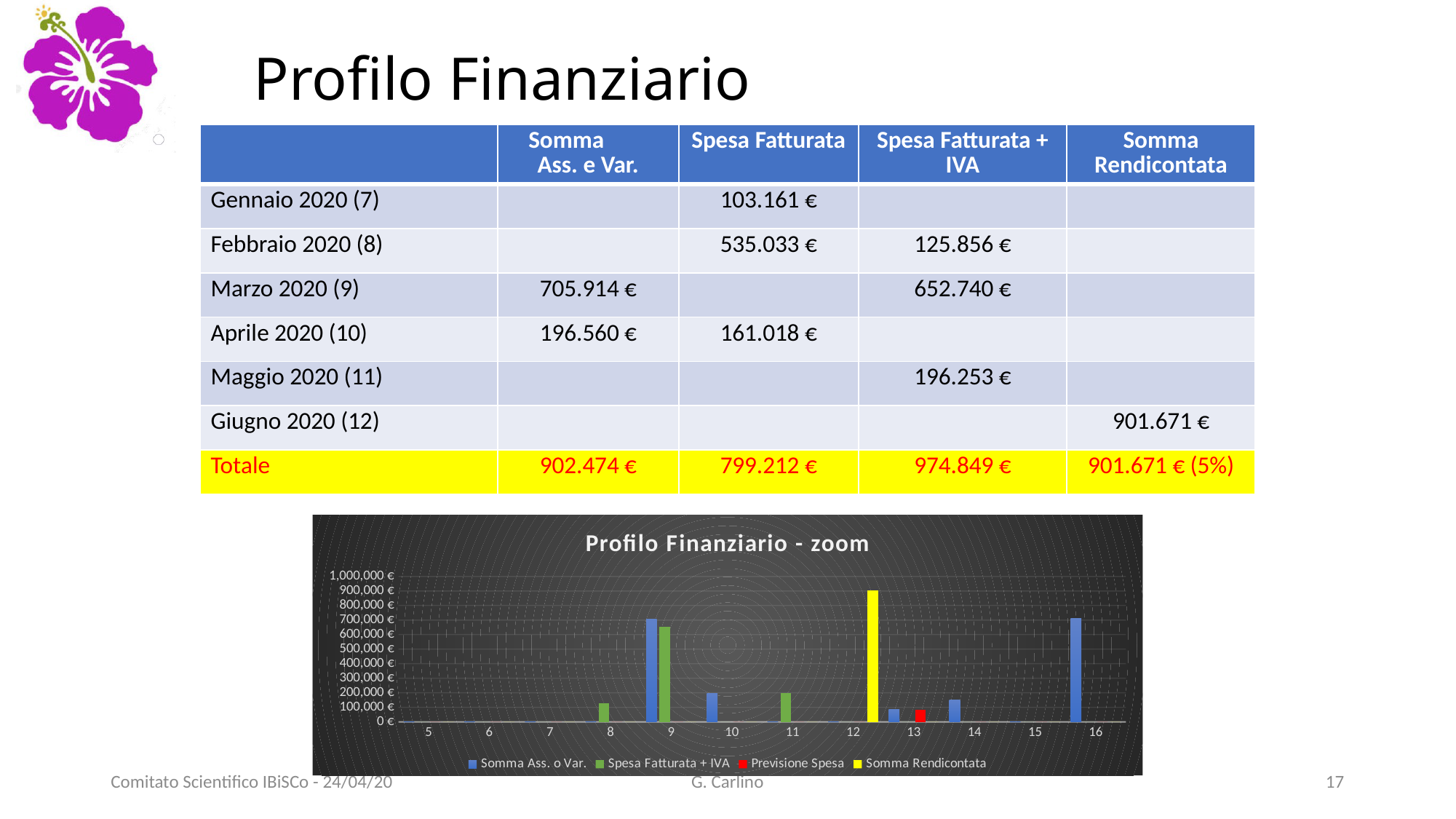
Is the Somma Ass. o Var. bar at category 9 greater or less than 600,000 €? greater Is the Somma Rendicontata bar at category 12 greater or less than 800,000 €? greater How many category labels are shown along the x axis of the chart? 12 How many series does the chart's legend list? 4 What kind of chart is shown on the slide? bar chart Is the Spesa Fatturata + IVA bar at category 8 greater or less than 200,000 €? less What colour represents the Previsione Spesa series in the chart's legend? red At which x-axis category does the tallest bar in the chart appear? 12 Which series has the tallest bar in the chart? Somma Rendicontata What is the title of the chart on the slide? Profilo Finanziario - zoom At category 9, which is larger: the Somma Ass. o Var. bar or the Spesa Fatturata + IVA bar? Somma Ass. o Var.